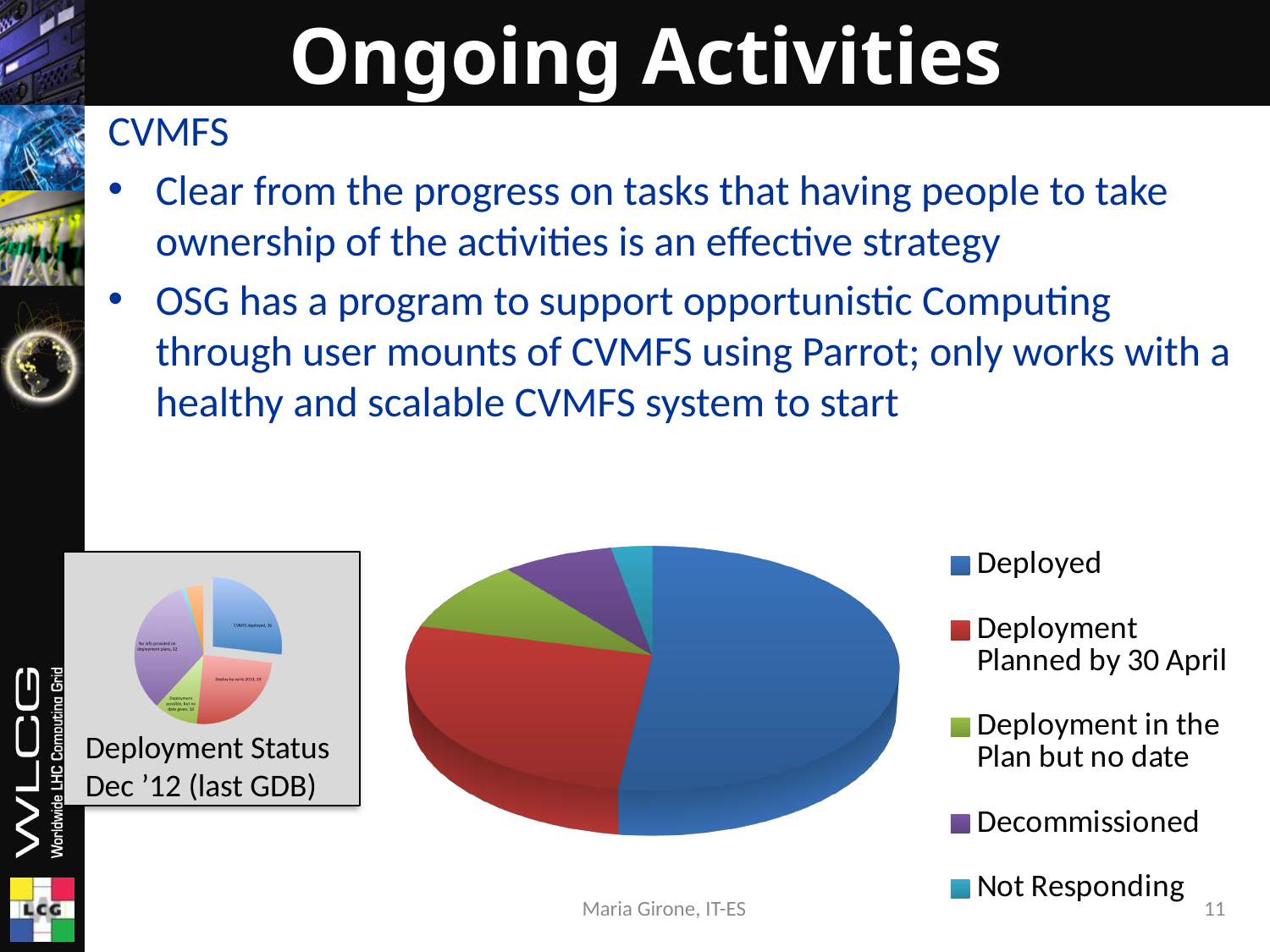
In the large pie chart, which slice is larger: Deployed or Deployment Planned by 30 April? Deployed How many slices does the large pie chart have? 5 What kind of chart is the large chart in the centre of the slide? pie chart In the large pie chart, how many categories does the legend list? 5 In the large pie chart, which category has the largest slice? Deployed In the large pie chart, what colour is the Deployed slice? blue In the large pie chart, which slice is larger: Decommissioned or Not Responding? Decommissioned In the large pie chart, which category has the smallest slice? Not Responding In the large pie chart, which slice is larger: Deployment Planned by 30 April or Deployment in the Plan but no date? Deployment Planned by 30 April What is the caption of the small inset pie chart on the left of the slide? Deployment Status Dec '12 (last GDB)